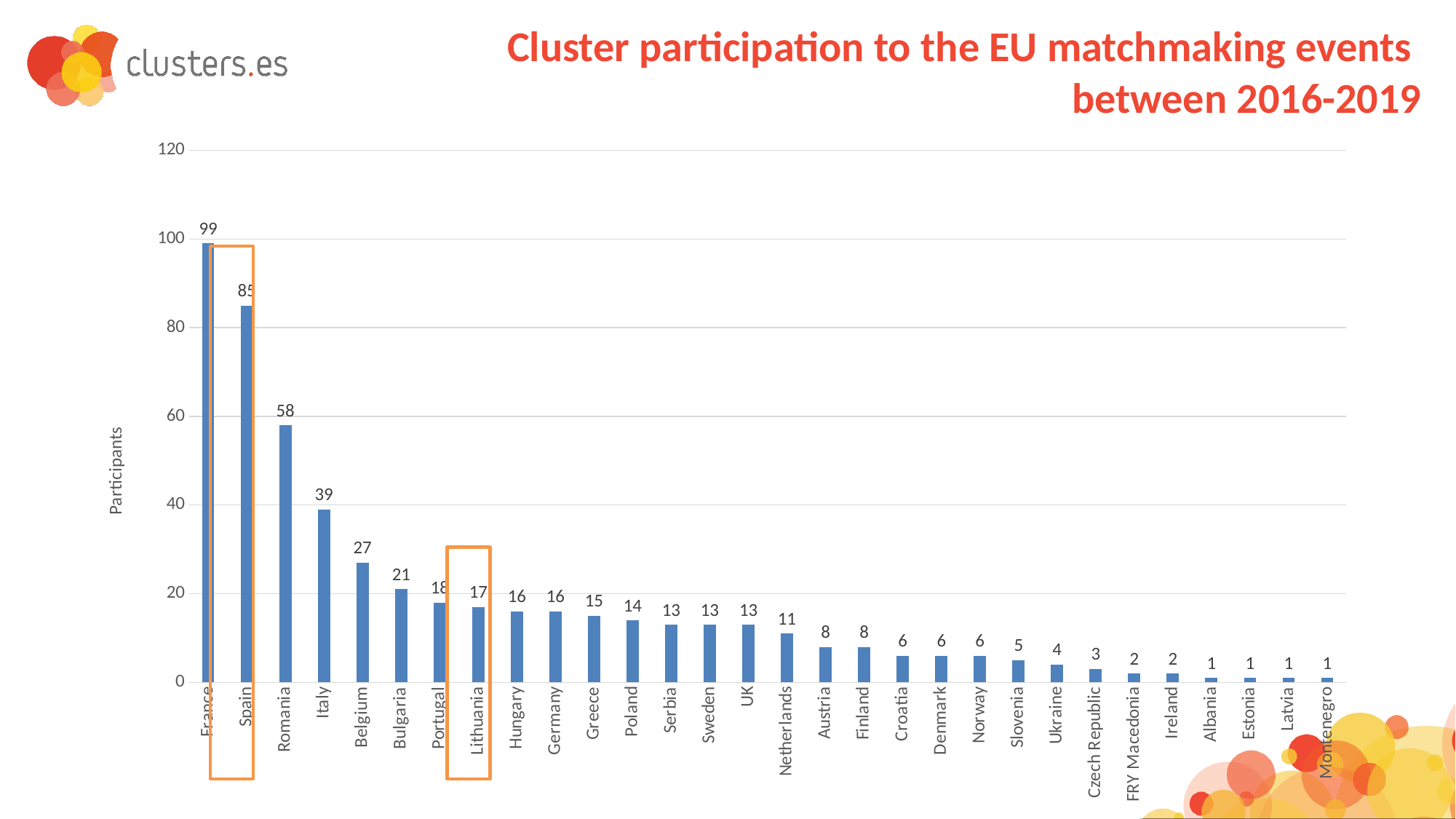
Which has more participants, Italy or Belgium? Italy Is the value for Spain greater or less than 80? greater What is the label of the y axis? Participants Do the values rise or fall from left to right along the x axis? Fall How many countries are shown on the x axis? 30 What is the difference in participants between France and Spain? 14 How many participants does France have? 99 What is the value for Lithuania? 17 How many participants are shown for Romania? 58 What kind of chart is shown on the slide? Bar chart Which country has the highest number of participants? France Which two countries are highlighted with orange boxes? Spain and Lithuania